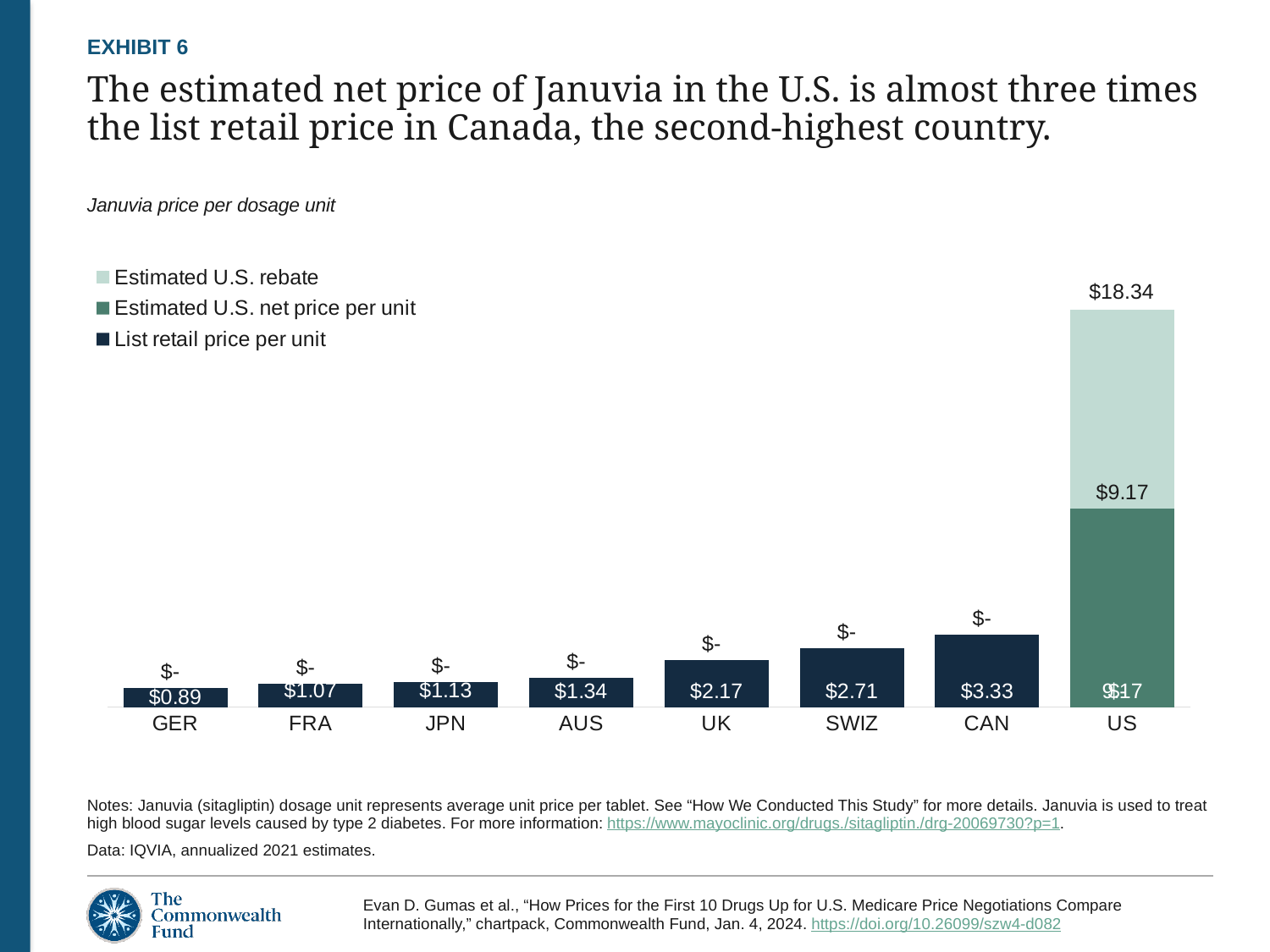
What is the list retail price per unit for GER? $0.89 What is the estimated U.S. net price per unit for the US? $9.17 Which has a higher list retail price per unit, UK or SWIZ? SWIZ Do the list retail prices per unit rise or fall from GER to CAN along the x axis? rise How many series does the legend list? 3 What kind of chart is shown on the slide? bar chart Which country has the highest list retail price per unit? CAN What is the list retail price per unit for CAN? $3.33 What is the subtitle of the chart? Januvia price per dosage unit What is the difference between the list retail price per unit for CAN and GER? $2.44 Which country has the lowest list retail price per unit? GER How many countries are shown on the x axis? 8